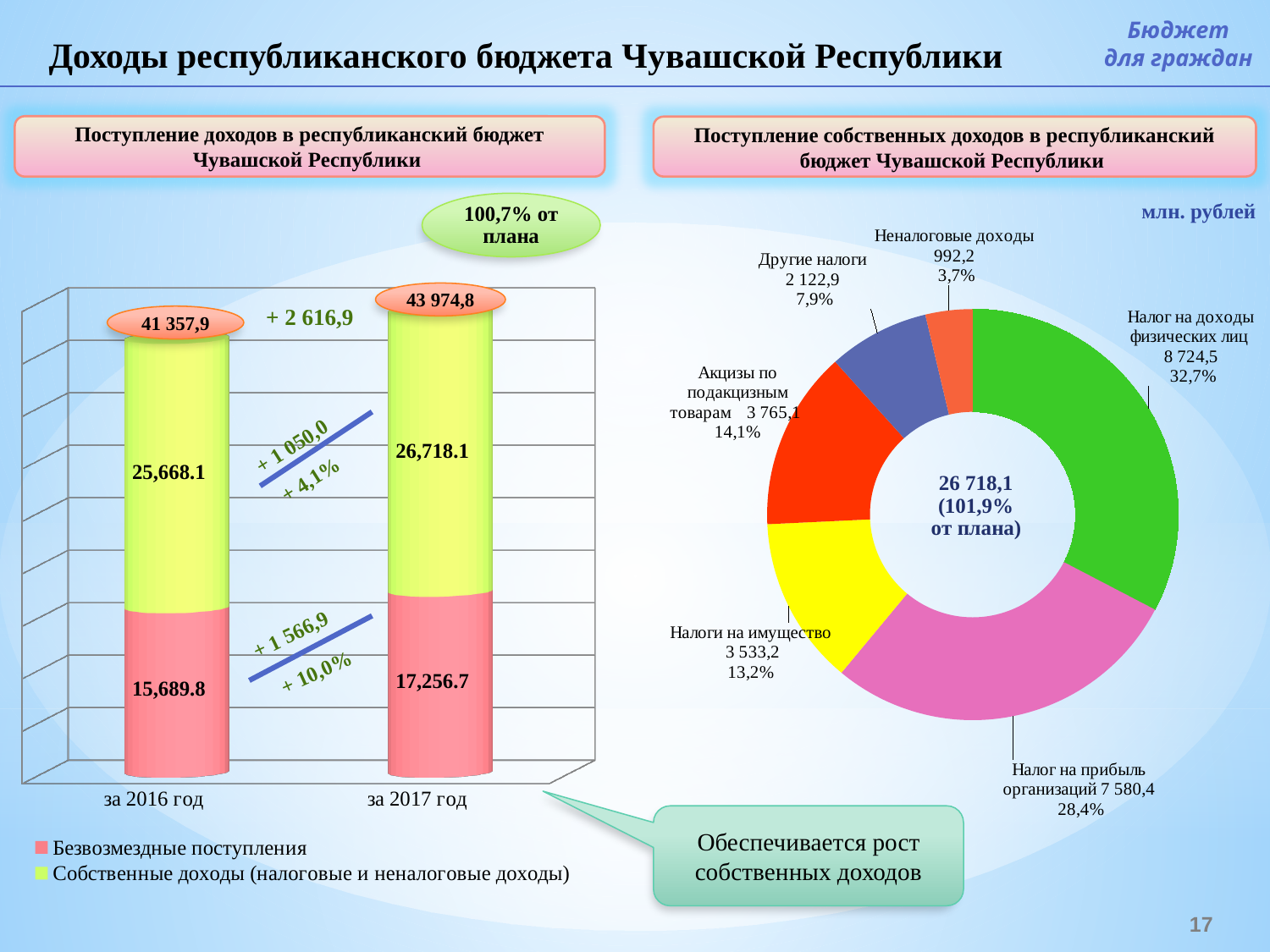
In the right chart, how many slices does the donut have? 6 In the left chart, what kind of chart is shown? Stacked bar chart In the right chart, what share of the total does Налог на доходы физических лиц represent? 32,7% In the left chart, how many series does the legend list? 2 In the left chart, which year has the larger value for Собственные доходы, за 2016 год or за 2017 год? за 2017 год In the left chart, what is the value of Собственные доходы for за 2016 год? 25,668.1 In the left chart (Поступление доходов в республиканский бюджет Чувашской Республики), what is the value of Безвозмездные поступления for за 2017 год? 17,256.7 In the left chart, what is the total of the stacked bar for за 2016 год? 41 357,9 In the right chart (Поступление собственных доходов), what is the value for Налог на прибыль организаций? 7 580,4 In the left chart, what is the total of the stacked bar for за 2017 год? 43 974,8 In the right chart, what is the difference between Акцизы по подакцизным товарам and Налоги на имущество? 231,9 In the right chart, which category has the smallest slice? Неналоговые доходы